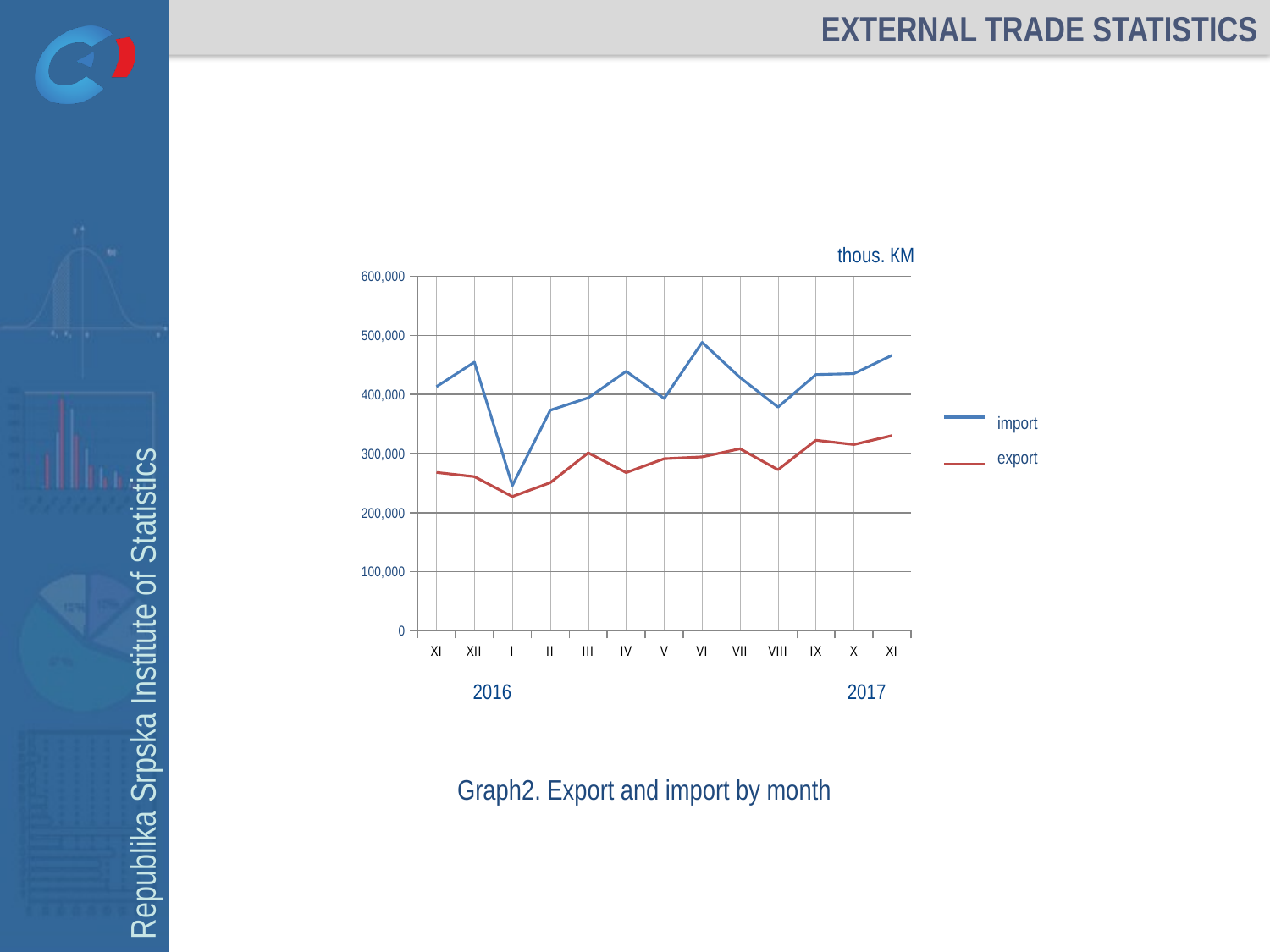
How many series does the legend list? 2 Does the export line rise or fall from VIII 2017 to IX 2017? rise In which month is the import value lowest? I 2017 Is the import value for VI 2017 greater or less than 400,000? greater What unit is shown above the chart? thous. KM How many months are plotted along the x axis? 13 In which month is the export value lowest? I 2017 Is the import value for I 2017 greater or less than 300,000? less Which is larger in XI 2016, import or export? import What kind of chart is shown on the slide? line chart In which month is the import value highest? VI 2017 Is the export value for I 2017 greater or less than 300,000? less